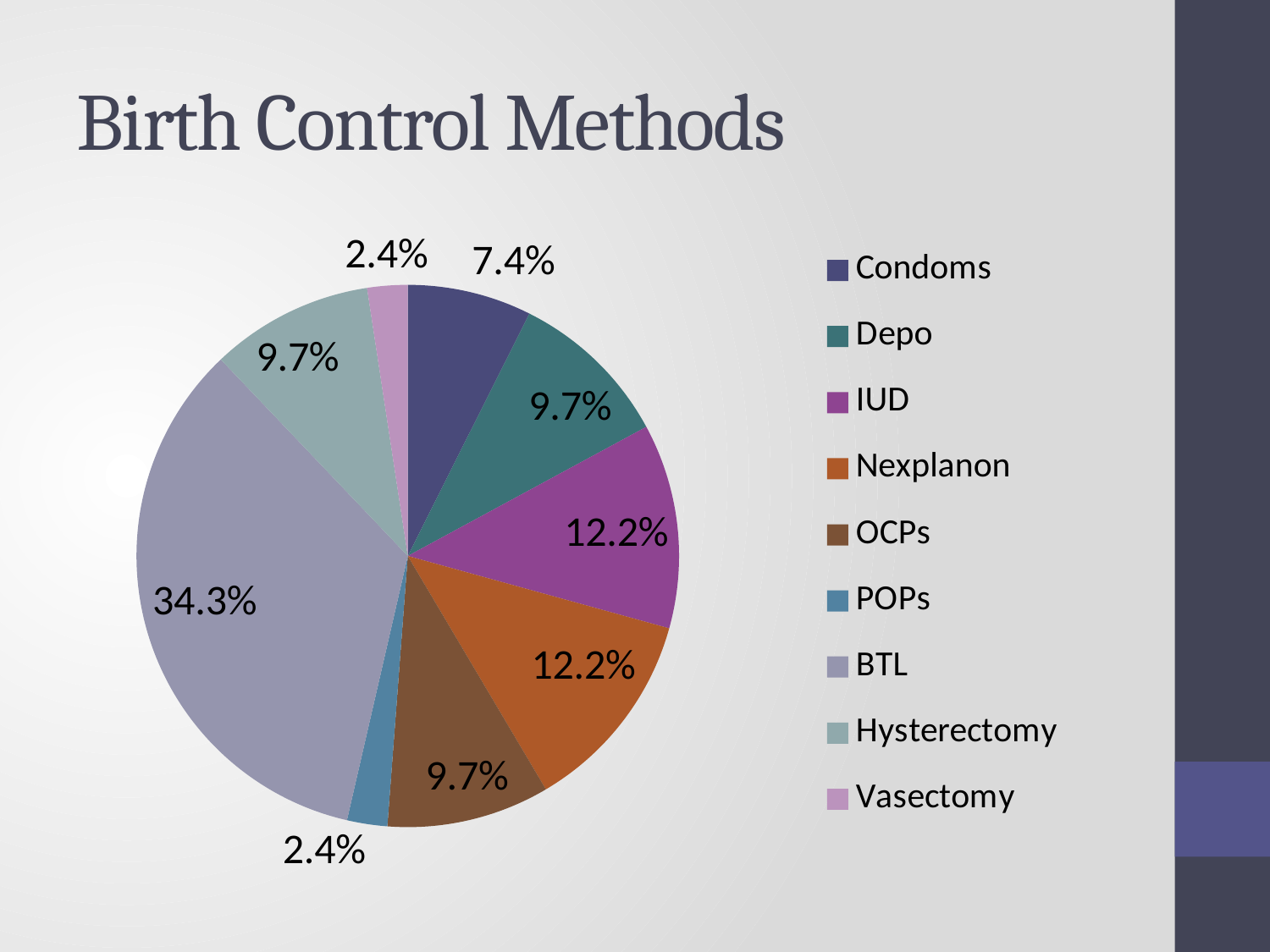
What is the difference between the BTL share and the Condoms share? 26.9% Which birth control method has the largest slice of the pie? BTL What type of chart is shown on the slide? pie chart What is the title of the chart? Birth Control Methods What is the value shown for Vasectomy? 2.4% What is the value shown for OCPs? 9.7% What is the difference between the Nexplanon share and the POPs share? 9.8% What is the value shown for IUD? 12.2% What is the value shown for Condoms? 7.4% What share of the pie does BTL represent? 34.3% How many categories does the legend list? 9 Which is larger, the slice for Condoms or the slice for Depo? Depo